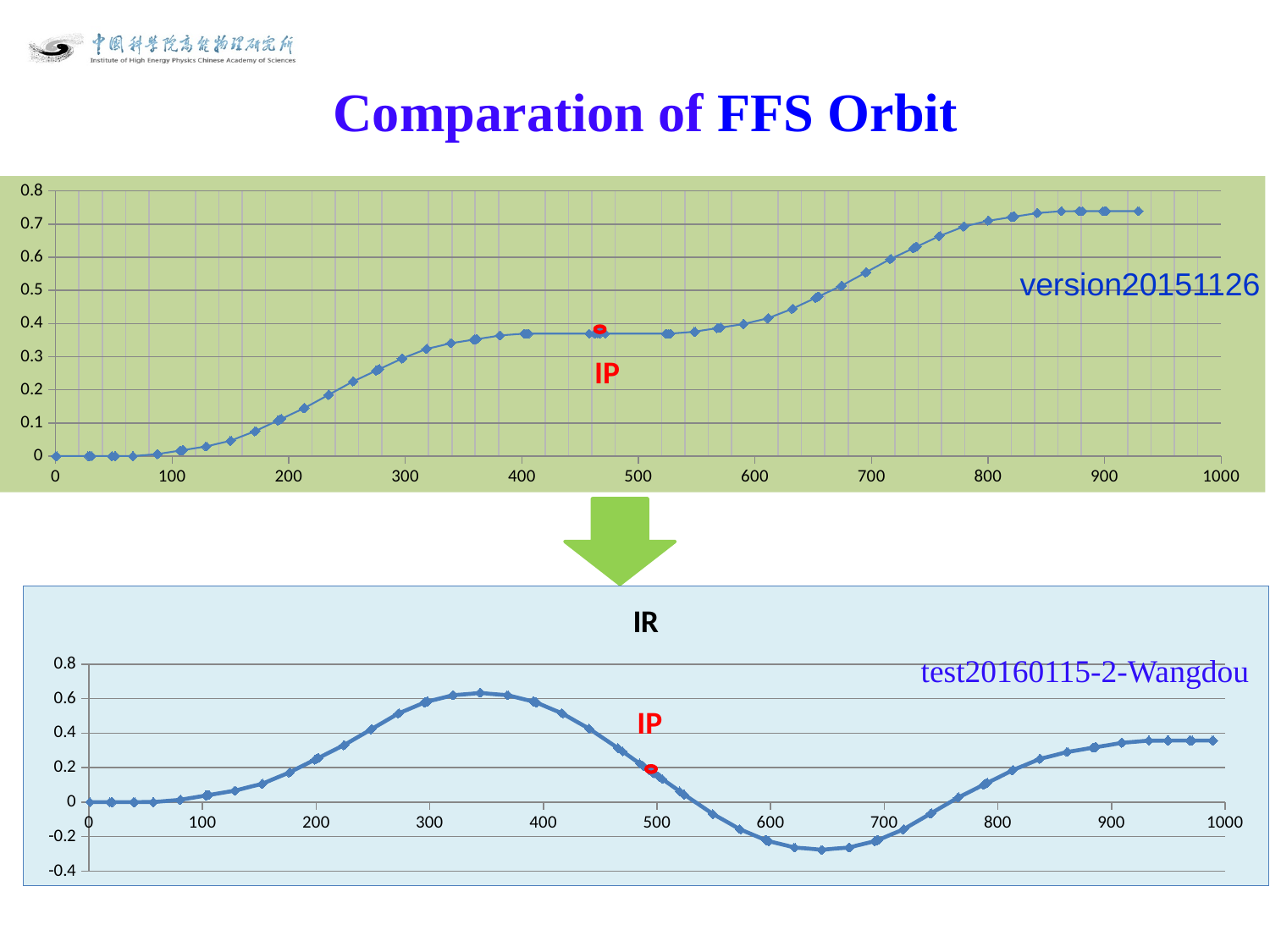
What label is written in red next to the highlighted point on each chart? IP In the top chart (version20151126), is the value at x = 200 greater or less than 0.2? less What is the title of the bottom chart? IR In the top chart (version20151126), is the value at x = 700 greater or less than 0.5? greater In the top chart (version20151126), is the value at x = 900 greater or less than 0.7? greater In the bottom chart (IR), which has the larger value: x = 300 or x = 600? x = 300 In the top chart (version20151126), which has the larger value: x = 400 or x = 800? x = 800 What kind of chart is the top chart (version20151126)? line chart In the top chart (version20151126), do the values overall rise or fall as x increases from 0 to 900? rise